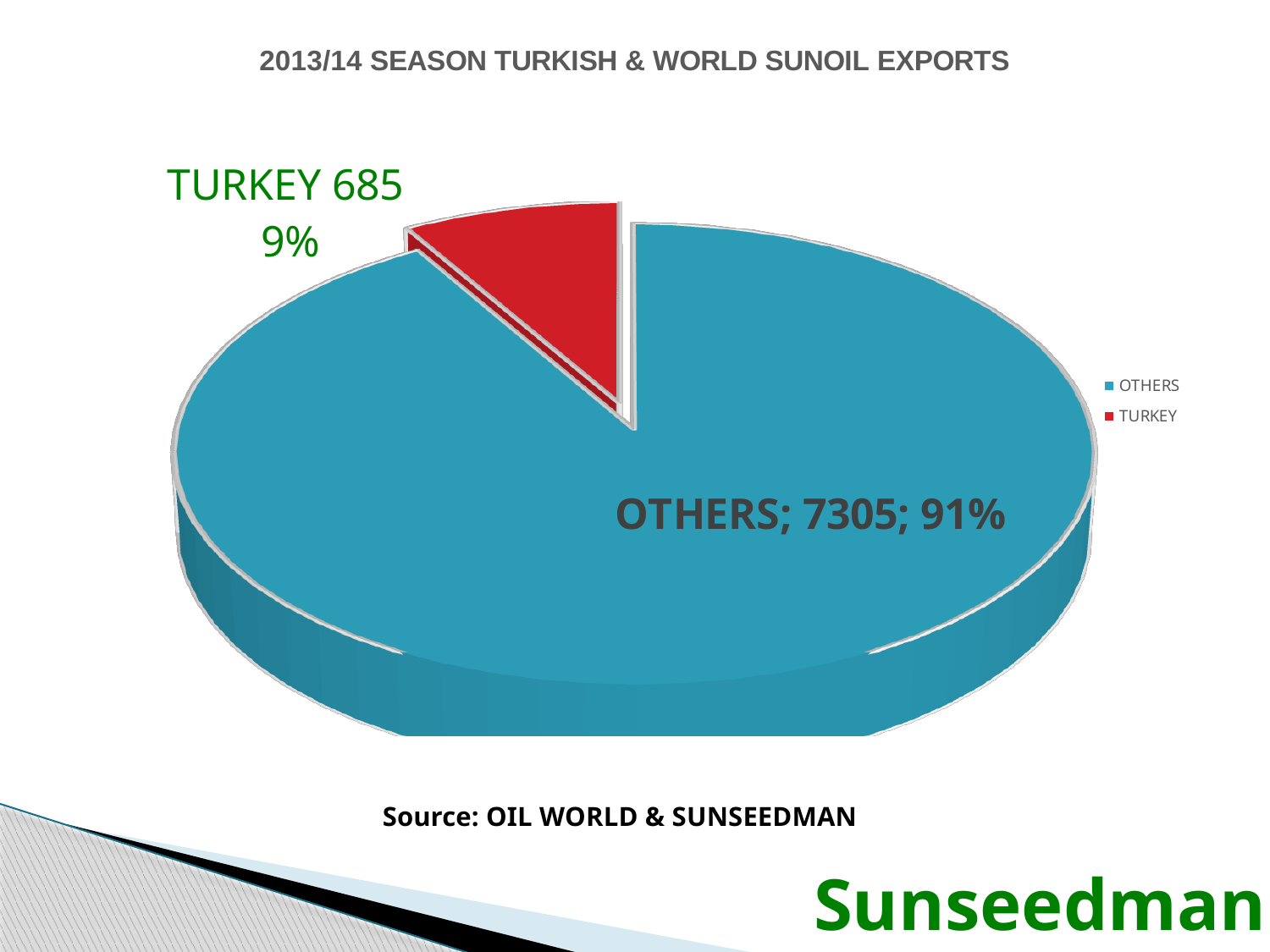
How many slices does the pie chart have? 2 What is the value for TURKEY in the pie chart? 685 Which slice is the largest in the pie chart? OTHERS Which is larger, the value for OTHERS or the value for TURKEY? OTHERS What share of the pie does TURKEY represent? 9% What is the title of the chart? 2013/14 SEASON TURKISH & WORLD SUNOIL EXPORTS What is the difference between the values for OTHERS and TURKEY? 6620 What share of the pie does OTHERS represent? 91% Which slice is the smallest in the pie chart? TURKEY What colour is the TURKEY slice in the pie chart? Red What type of chart is shown on the slide? Pie chart What is the value for OTHERS in the pie chart? 7305